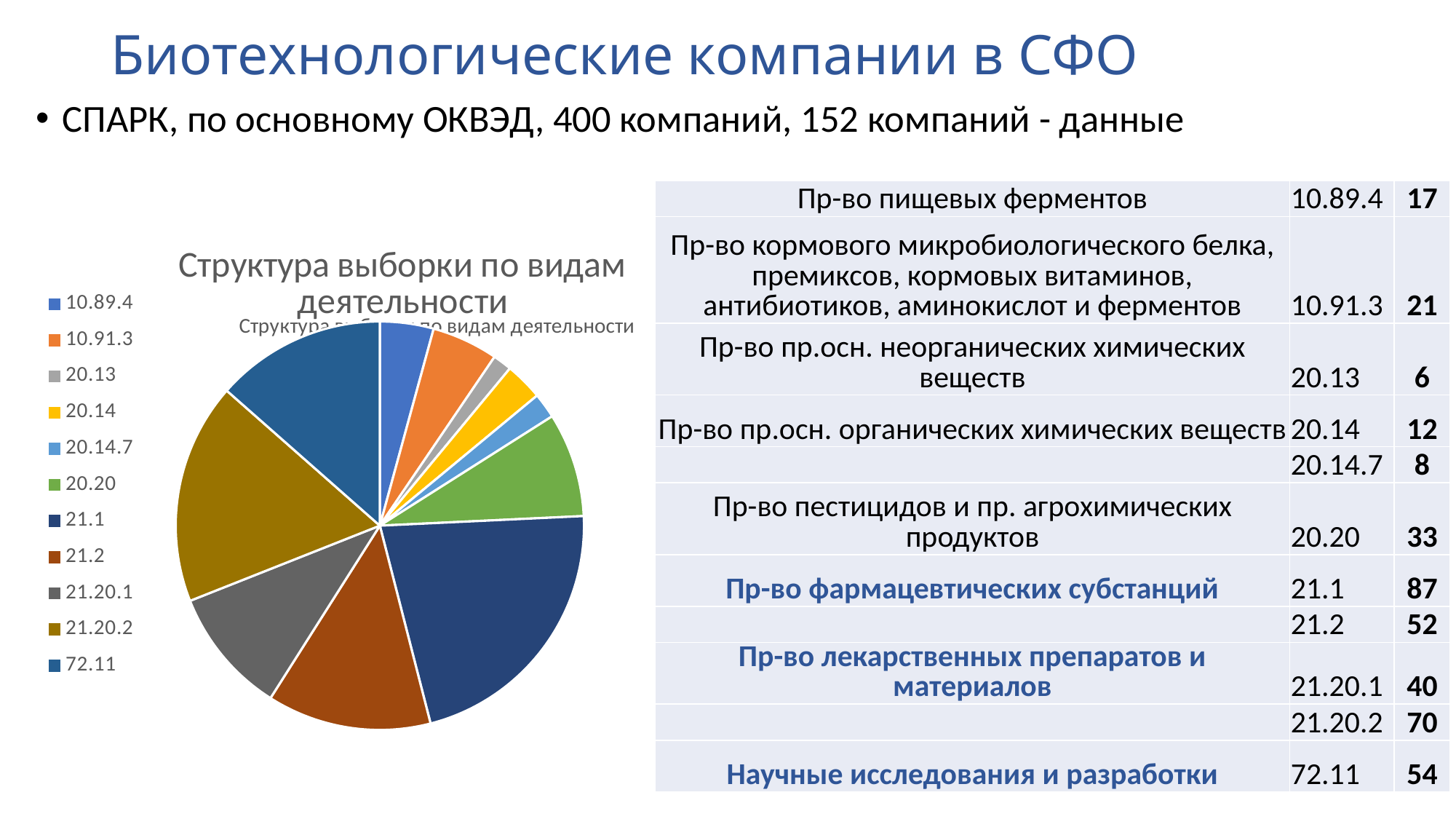
What kind of chart is shown on the slide? pie chart Which slice is larger in the pie chart, 21.20.2 or 21.20.1? 21.20.2 What is the title of the pie chart? Структура выборки по видам деятельности Which slice is larger in the pie chart, 72.11 or 10.89.4? 72.11 How many entries does the legend of the pie chart list? 11 How many categories (slices) does the pie chart have? 11 Which slice is larger in the pie chart, 21.20.1 or 10.91.3? 21.20.1 Which category has the largest slice in the pie chart? 21.1